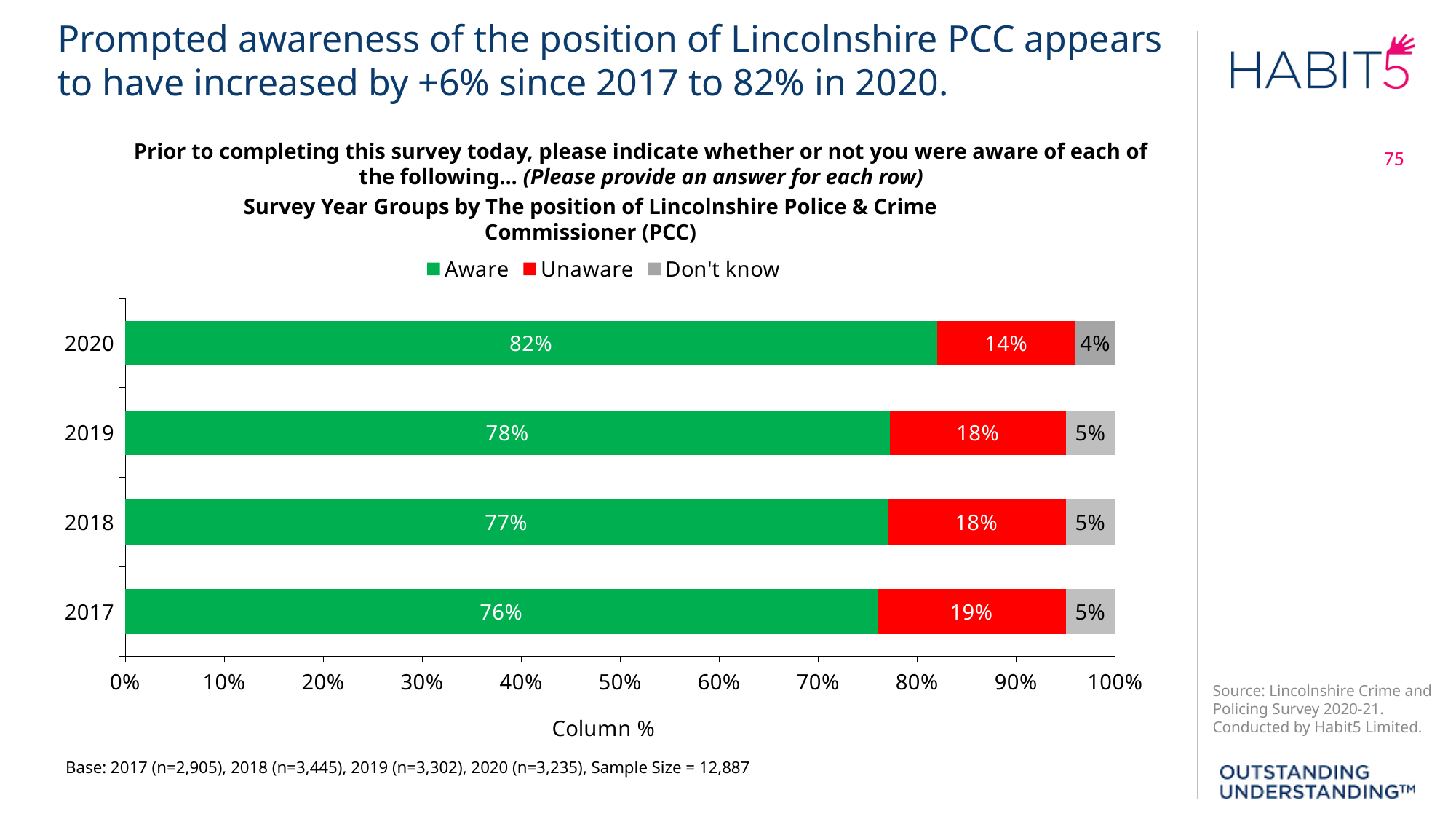
What is the Aware value for 2018? 77% How many survey years are shown on the chart? 4 What is the Unaware value for 2017? 19% Which survey year has the lowest Aware percentage? 2017 What kind of chart is shown on the slide? Stacked bar chart What is the Don't know value for 2019? 5% What percentage of respondents were Aware of the position of Lincolnshire PCC in 2020? 82% Which colour represents the Unaware series in the chart? Red Which survey year has the highest Aware percentage? 2020 How many series does the legend list? 3 Is the Unaware value larger in 2017 or in 2020? 2017 What is the difference between the Aware percentage in 2020 and in 2017? 6%